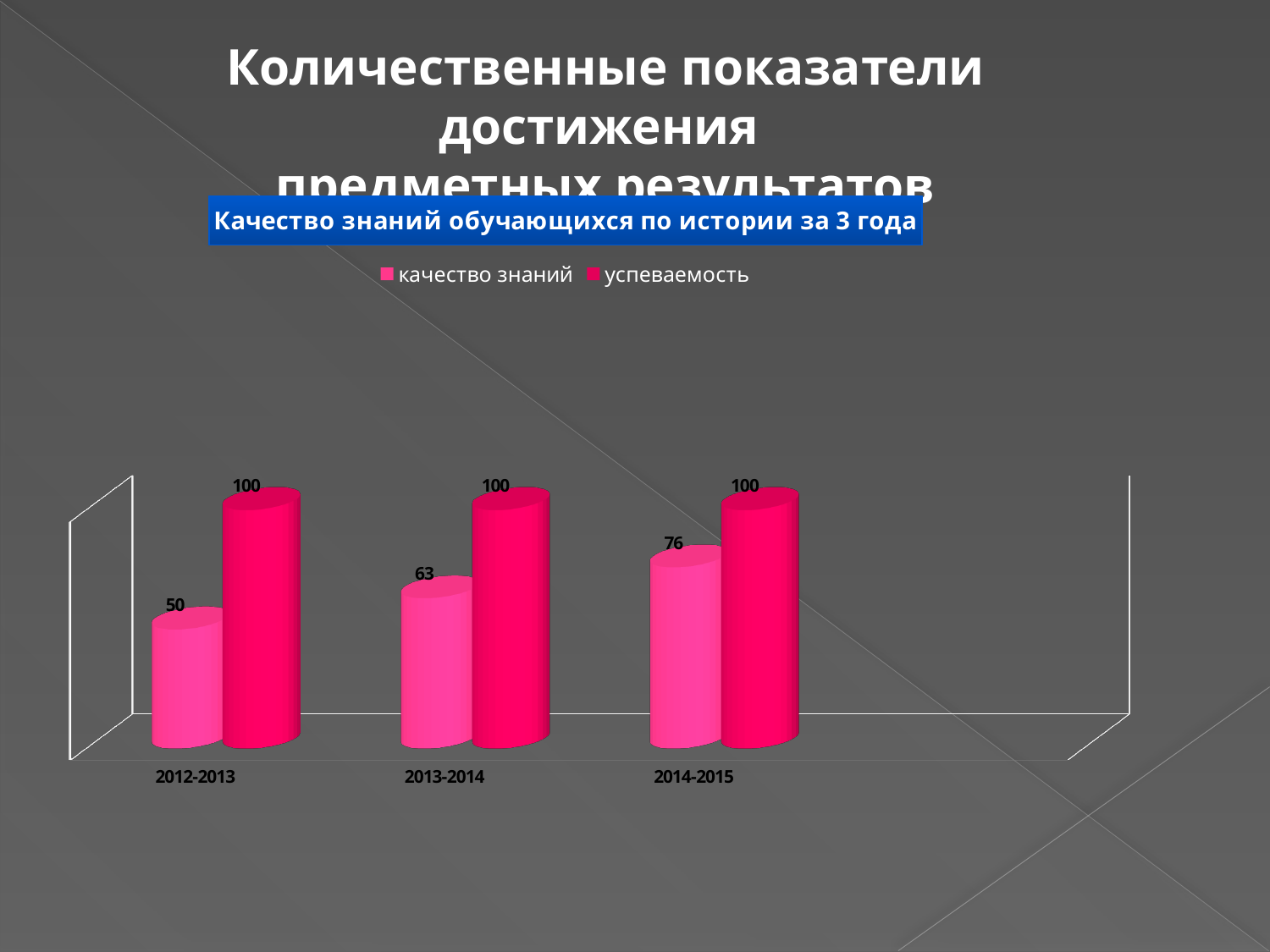
Which year has the highest value for качество знаний? 2014-2015 How many year categories are shown on the x axis? 3 What is the value of качество знаний for 2013-2014? 63 What is the difference between успеваемость and качество знаний in 2012-2013? 50 What is the value of качество знаний for 2014-2015? 76 Which year has the lowest value for качество знаний? 2012-2013 What is the value of качество знаний for 2012-2013? 50 What is the value of успеваемость for 2014-2015? 100 Does качество знаний rise or fall across the years from 2012-2013 to 2014-2015? rise Which is larger in 2013-2014: качество знаний or успеваемость? успеваемость By how much did качество знаний increase from 2012-2013 to 2014-2015? 26 How many series does the legend list? 2